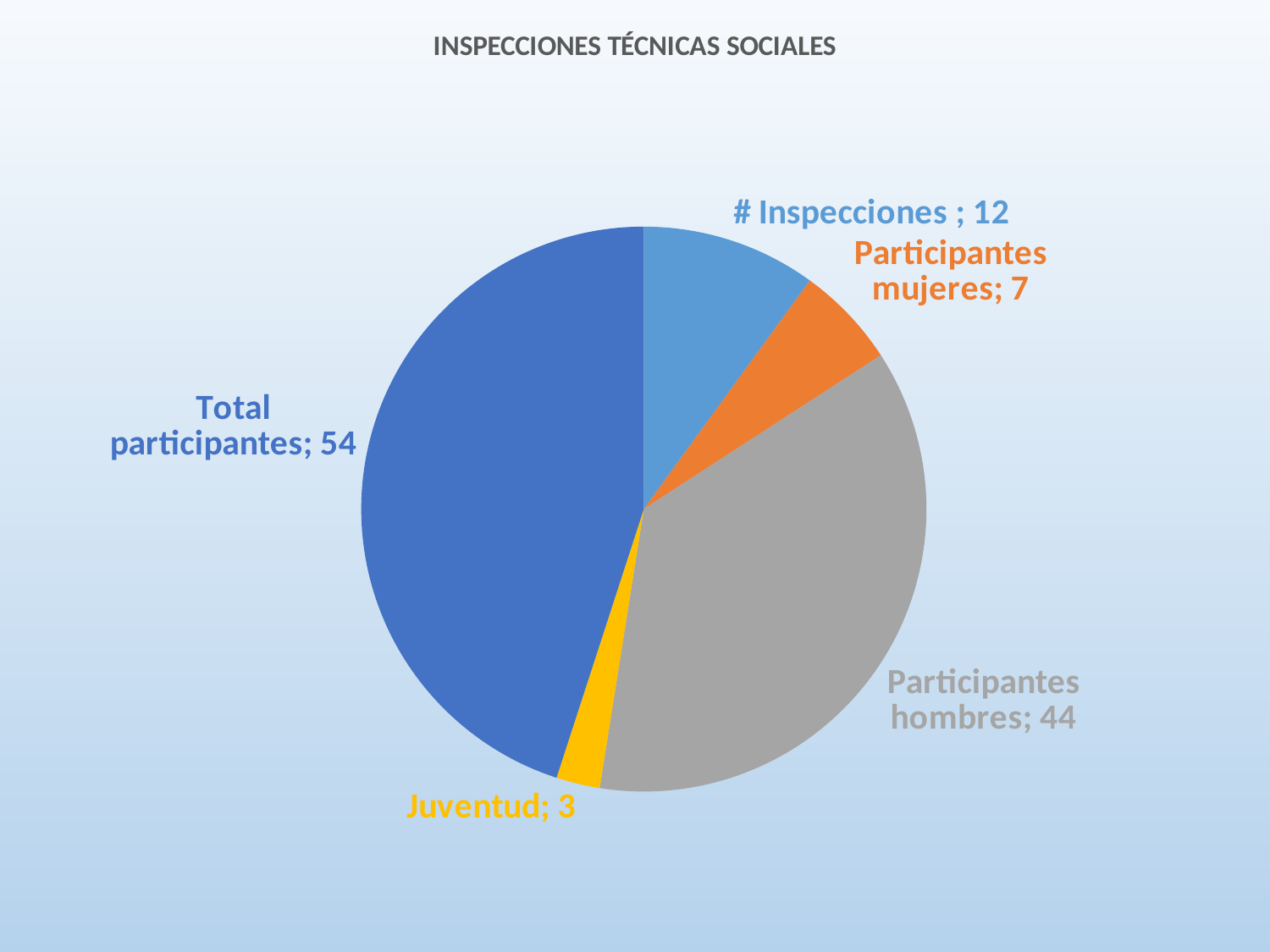
Which slice has the largest value? Total participantes What is the difference between Participantes hombres and Participantes mujeres? 37 How many slices does the pie chart have? 5 Which slice has the smallest value? Juventud What share of the pie does the Total participantes slice represent? 45% Which is larger, # Inspecciones or Participantes mujeres? # Inspecciones What is the value for Participantes mujeres? 7 What is the value for Juventud? 3 What is the value for # Inspecciones? 12 What is the title of the chart? INSPECCIONES TÉCNICAS SOCIALES What type of chart is shown on the slide? Pie chart What is the value for Participantes hombres? 44